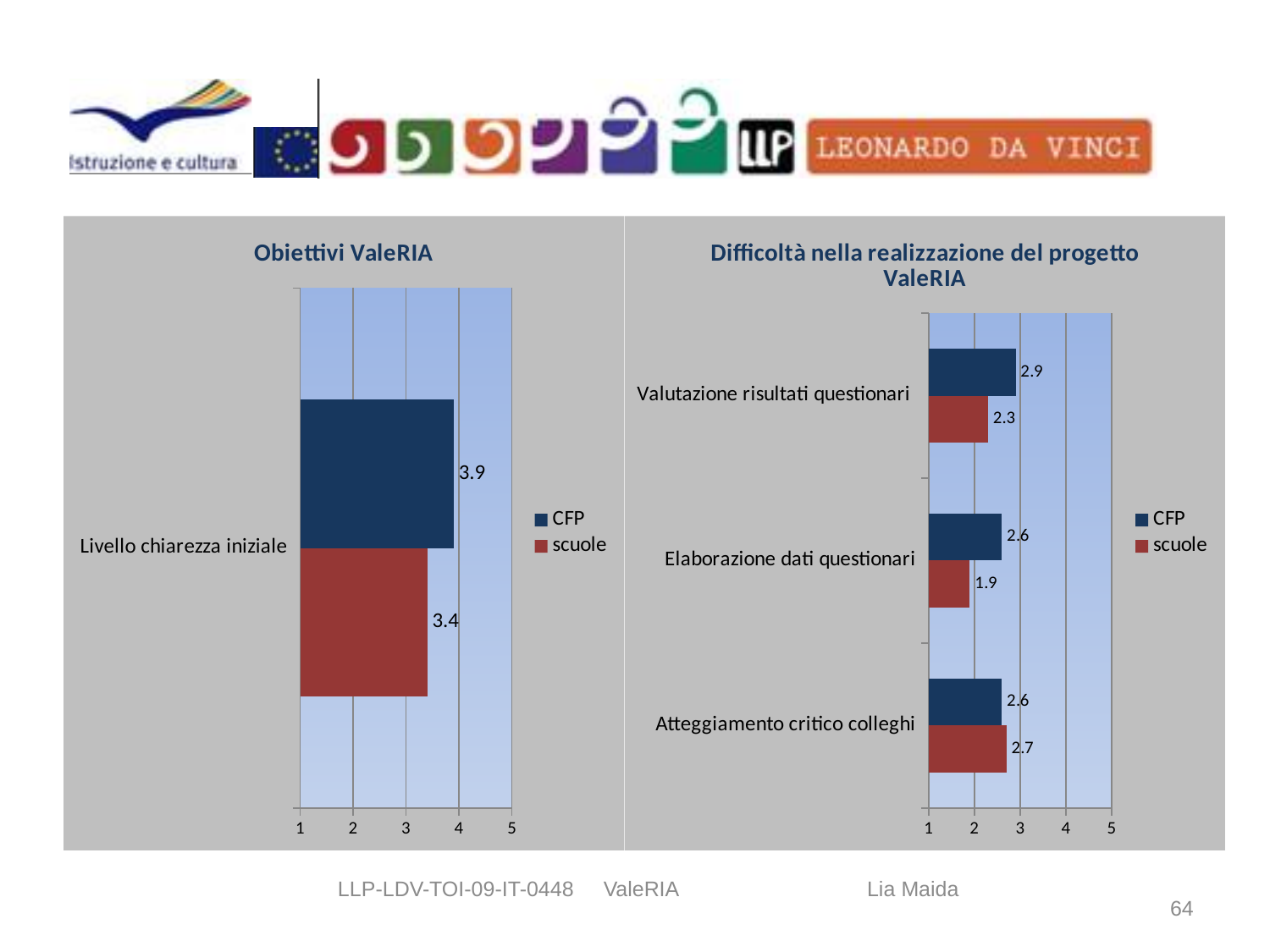
In the 'Difficoltà nella realizzazione del progetto ValeRIA' chart, what is the difference between the CFP and scuole values for 'Elaborazione dati questionari'? 0.7 In the 'Obiettivi ValeRIA' chart, what is the value for CFP for 'Livello chiarezza iniziale'? 3.9 What type of chart is the 'Obiettivi ValeRIA' chart? Bar chart In the 'Difficoltà nella realizzazione del progetto ValeRIA' chart, what is the scuole value for 'Atteggiamento critico colleghi'? 2.7 In the 'Obiettivi ValeRIA' chart, what is the difference between the CFP and scuole values for 'Livello chiarezza iniziale'? 0.5 In the 'Difficoltà nella realizzazione del progetto ValeRIA' chart, which category has the highest CFP value? Valutazione risultati questionari In the 'Difficoltà nella realizzazione del progetto ValeRIA' chart, what is the CFP value for 'Valutazione risultati questionari'? 2.9 In the 'Obiettivi ValeRIA' chart, which series has the larger value: CFP or scuole? CFP In the 'Difficoltà nella realizzazione del progetto ValeRIA' chart, what is the scuole value for 'Elaborazione dati questionari'? 1.9 In the 'Obiettivi ValeRIA' chart, what is the value for scuole for 'Livello chiarezza iniziale'? 3.4 How many categories are shown in the 'Difficoltà nella realizzazione del progetto ValeRIA' chart? 3 In the 'Difficoltà nella realizzazione del progetto ValeRIA' chart, which category has the lowest scuole value? Elaborazione dati questionari